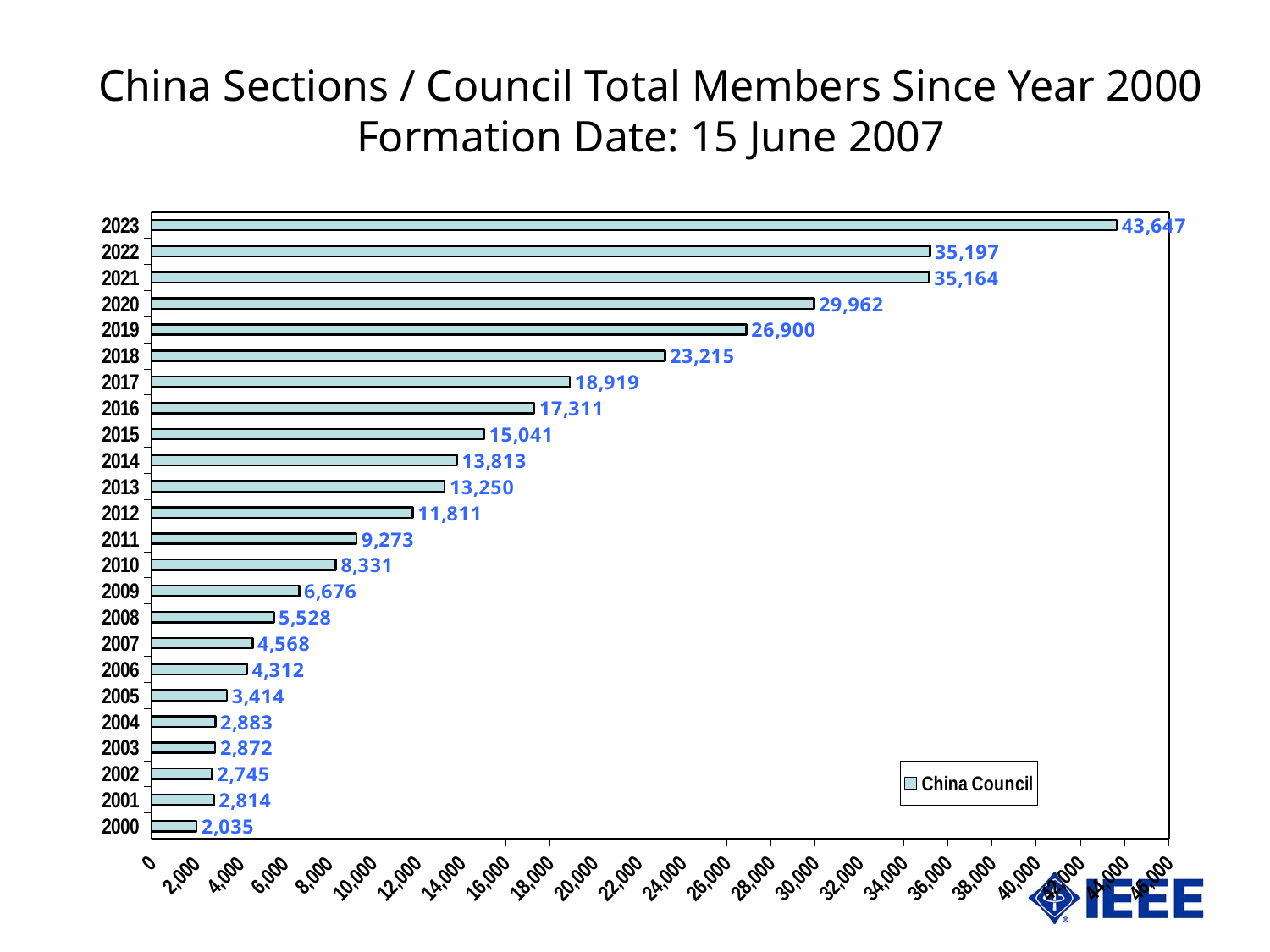
What is the name of the series shown in the legend? China Council What is the value shown for 2007? 4,568 What is the value shown for 2015? 15,041 How many years are shown on the chart? 24 What is the total number of members for 2023? 43,647 Which is larger, the value for 2001 or the value for 2002? 2001 Which year has the highest number of members? 2023 What type of chart is shown on the slide? bar chart How many series does the legend list? 1 What is the difference between the values for 2023 and 2022? 8,450 Which year has the lowest number of members? 2000 What is the value shown for 2000? 2,035